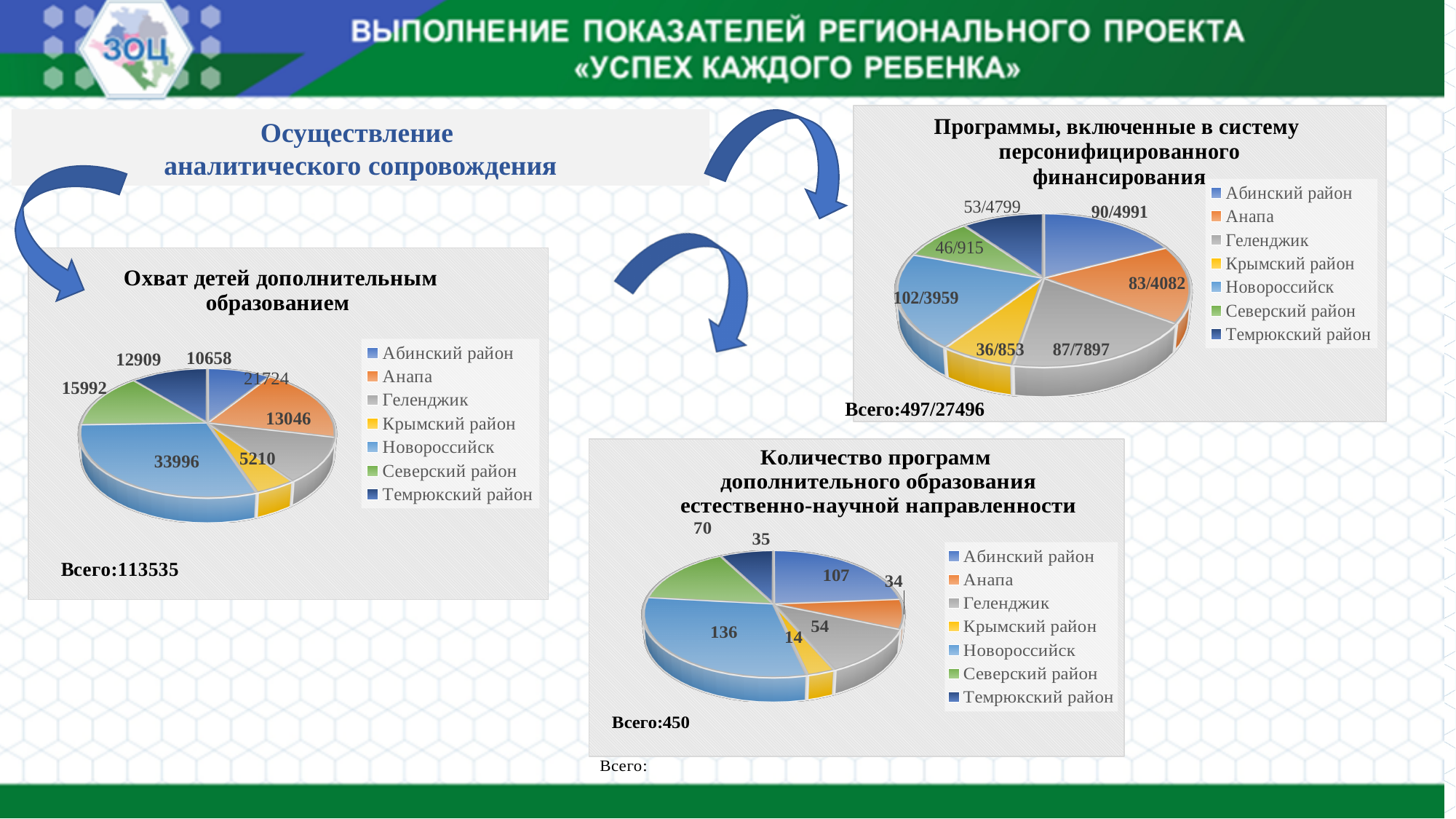
How many districts are listed in the legend of the chart 'Количество программ дополнительного образования естественно-научной направленности'? 7 What total is shown below the chart 'Программы, включенные в систему персонифицированного финансирования'? 497/27496 In the chart 'Охват детей дополнительным образованием', what is the value for Новороссийск? 33996 In the chart 'Охват детей дополнительным образованием', which district has the smallest slice? Крымский район In the chart 'Программы, включенные в систему персонифицированного финансирования', what is the label for Крымский район? 36/853 In the chart 'Охват детей дополнительным образованием', what is the difference between the values for Северский район and Темрюкский район? 3083 What type of chart is used for 'Охват детей дополнительным образованием'? Pie chart In the chart 'Количество программ дополнительного образования естественно-научной направленности', what is the value for Абинский район? 107 In the chart 'Количество программ дополнительного образования естественно-научной направленности', which district has the largest value? Новороссийск In the chart 'Программы, включенные в систему персонифицированного финансирования', what is the label for Новороссийск? 102/3959 What total is shown below the chart 'Охват детей дополнительным образованием'? 113535 In the chart 'Количество программ дополнительного образования естественно-научной направленности', which is larger: the value for Северский район or Геленджик? Северский район